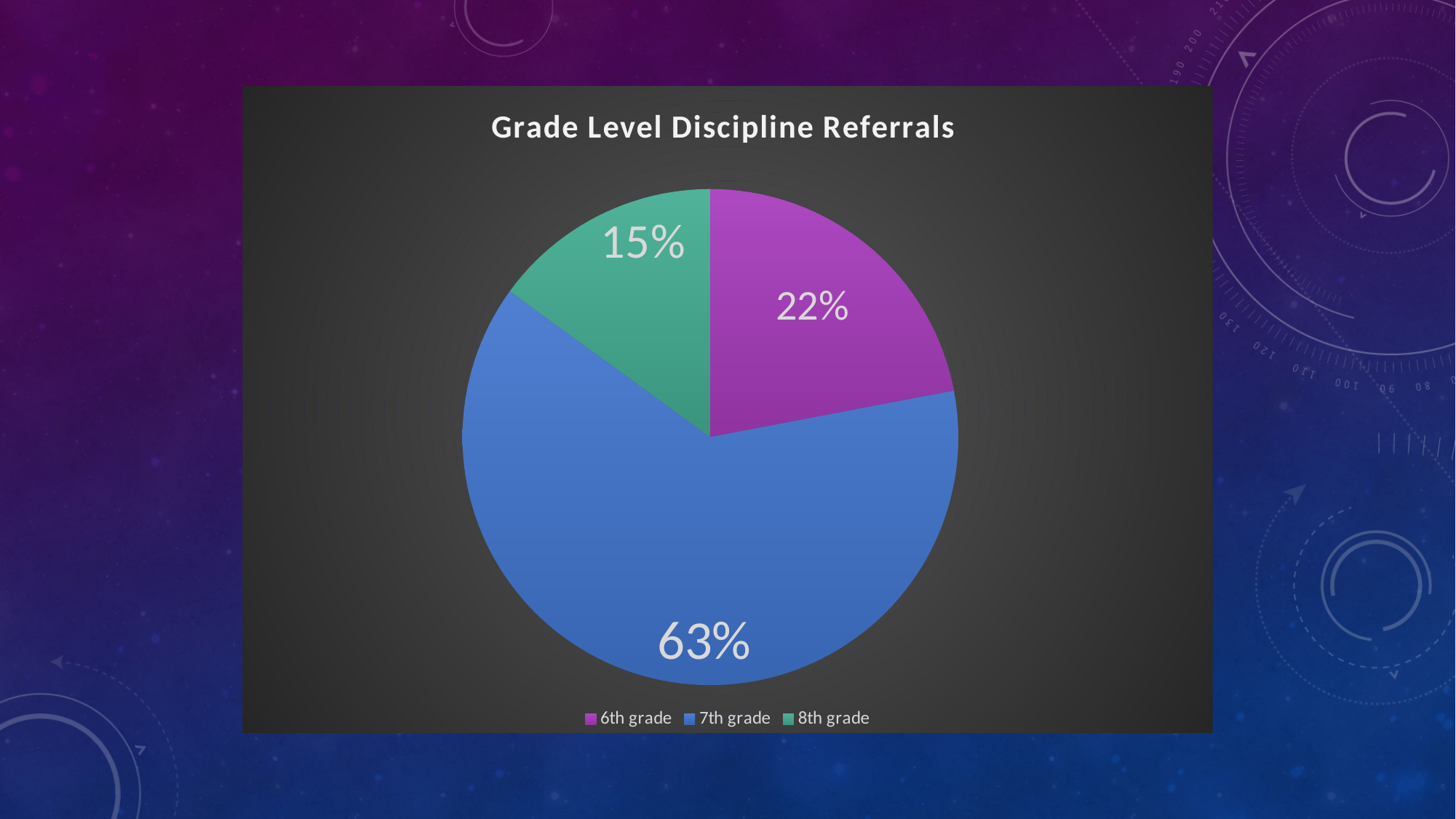
What is the difference in percentage points between the 7th grade and 6th grade shares? 41 What share of discipline referrals is attributed to 6th grade? 22% Which grade level has the largest share of discipline referrals? 7th grade What kind of chart is shown on the slide? pie chart How many grade levels are shown in the pie chart? 3 Which has a larger share of referrals, 6th grade or 8th grade? 6th grade What colour is the slice for 8th grade? green What share of discipline referrals is attributed to 7th grade? 63% What share of discipline referrals is attributed to 8th grade? 15% How many entries does the legend list? 3 Which grade level has the smallest share of discipline referrals? 8th grade What is the title of the chart? Grade Level Discipline Referrals